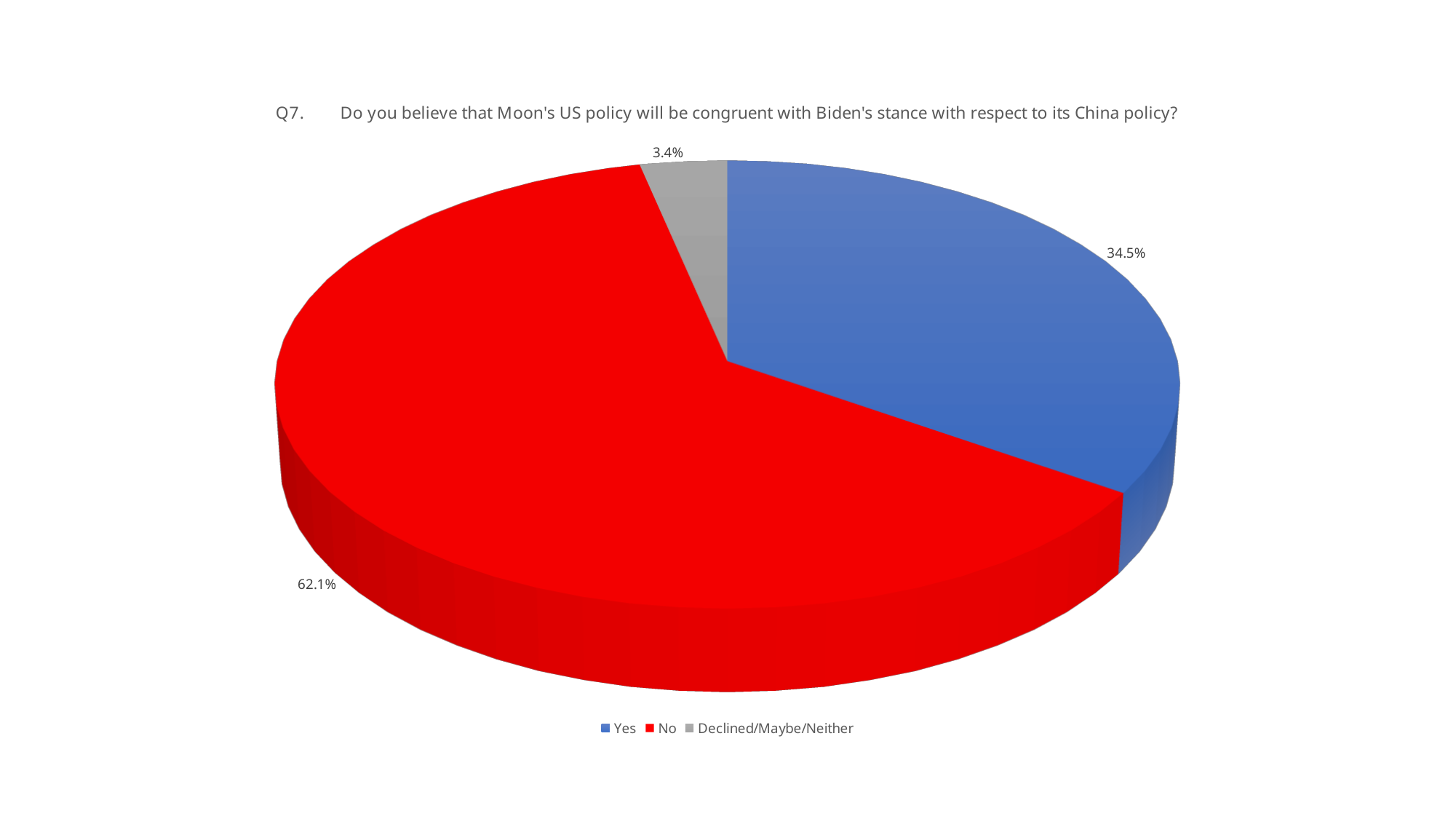
What is the question number shown in the chart title? Q7 What kind of chart is shown on the slide? Pie chart Which response has the largest share of the pie? No Which response has the smallest share of the pie? Declined/Maybe/Neither What percentage of respondents answered "Yes"? 34.5% How many categories does the pie chart show? 3 What share of the pie does the "No" slice represent? 62.1% What percentage of respondents are in the "Declined/Maybe/Neither" category? 3.4% What colour is the "No" slice in the pie chart? Red What percentage of respondents answered "No"? 62.1% What is the difference in percentage points between the "No" and "Yes" shares? 27.6 Which is larger, the share for "Yes" or the share for "Declined/Maybe/Neither"? Yes